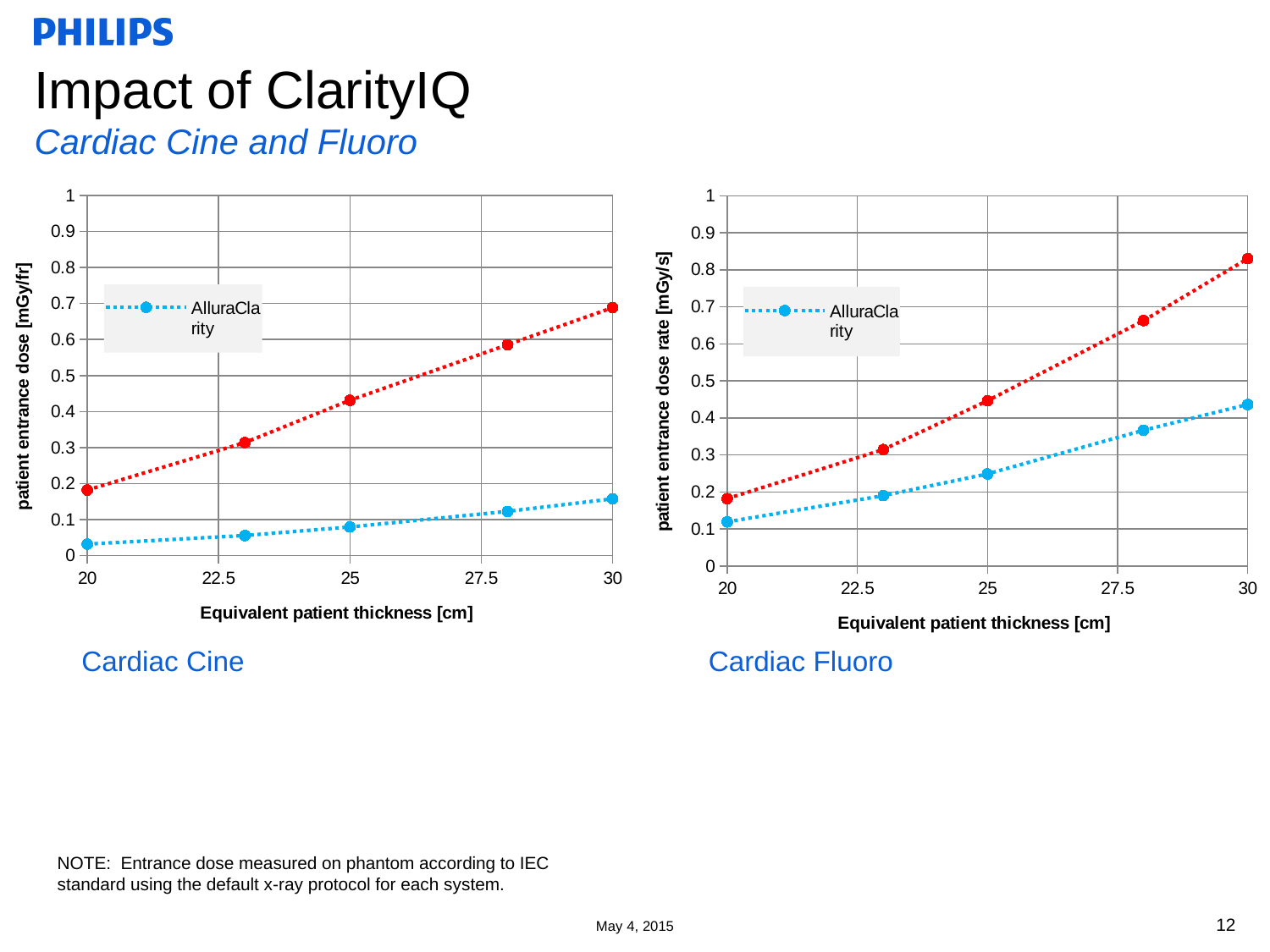
How many series does the legend list in the Cardiac Fluoro chart? 1 What is the y-axis title of the Cardiac Fluoro chart? patient entrance dose rate [mGy/s] In the Cardiac Fluoro chart, which series has the higher value at 27.5 cm, the red series or AlluraClarity? the red series In the Cardiac Fluoro chart, do the AlluraClarity values rise or fall as equivalent patient thickness increases from 20 to 30 cm? rise In the Cardiac Fluoro chart, is the red series value at 30 cm greater or less than 0.8? greater In the Cardiac Fluoro chart, is the AlluraClarity value at 30 cm greater or less than 0.4? greater What kind of chart is the Cardiac Cine chart on the left? line chart In the Cardiac Cine chart, is the red series value at 25 cm greater or less than 0.5? less In the Cardiac Cine chart, at which equivalent patient thickness is the AlluraClarity value lowest? 20 What is the x-axis title of the Cardiac Cine chart? Equivalent patient thickness [cm] How many data points does the AlluraClarity series have in the Cardiac Cine chart? 5